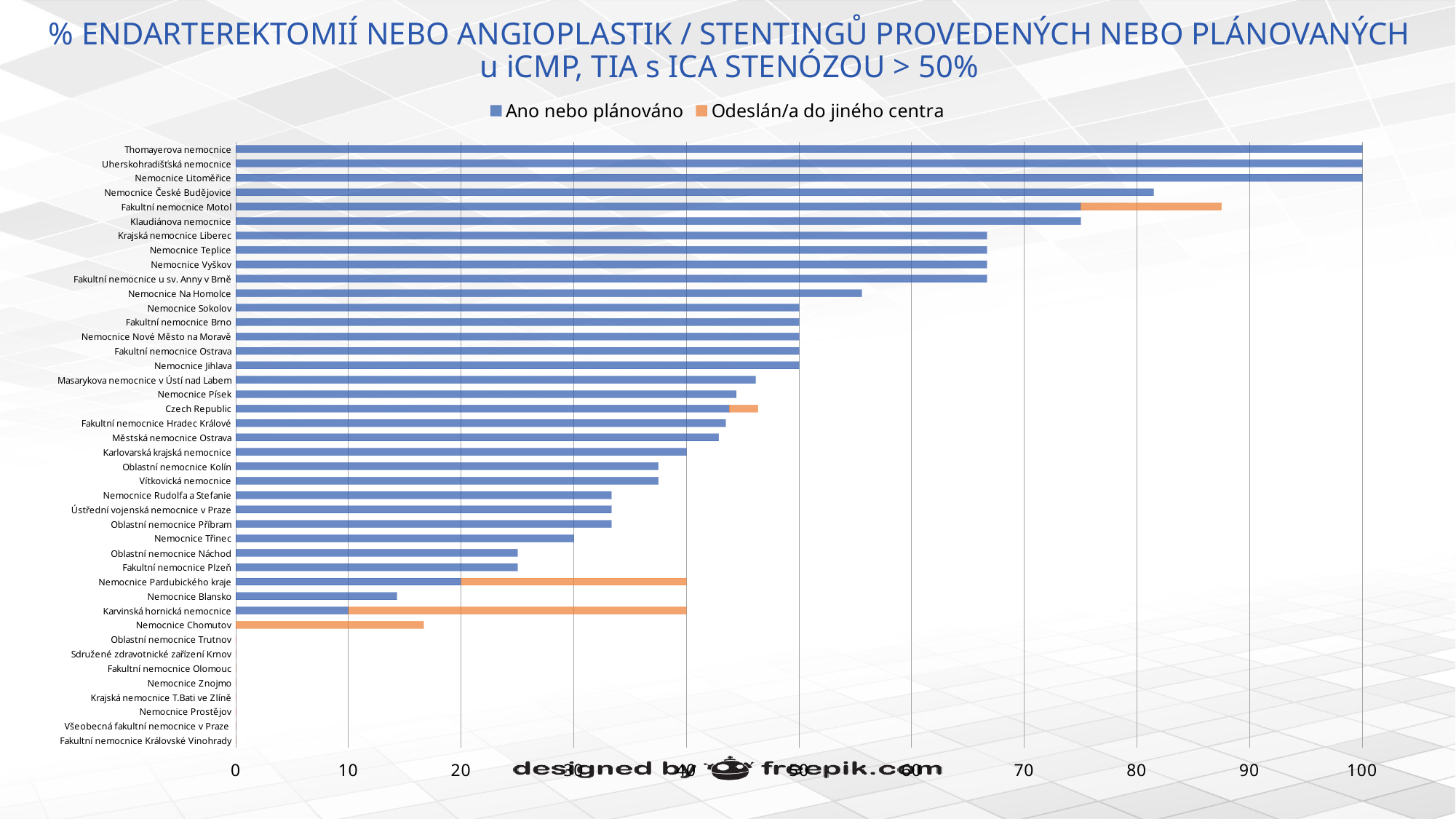
How many series does the legend list? 2 What kind of chart is shown on the slide? bar chart What are the two series named in the legend? Ano nebo plánováno; Odeslán/a do jiného centra What is the value of 'Ano nebo plánováno' for Thomayerova nemocnice? 100 Which has a larger 'Ano nebo plánováno' value, Krajská nemocnice Liberec or Oblastní nemocnice Kolín? Krajská nemocnice Liberec What is the total of the stacked bar for Nemocnice Pardubického kraje? 40 What is the value of 'Ano nebo plánováno' for Nemocnice Třinec? 30 What is the value of 'Ano nebo plánováno' for Karvinská hornická nemocnice? 10 What is the difference between the 'Ano nebo plánováno' values for Thomayerova nemocnice and Nemocnice Třinec? 70 What is the value of 'Ano nebo plánováno' for Karlovarská krajská nemocnice? 40 Is the 'Ano nebo plánováno' value for Fakultní nemocnice Motol greater or less than 70? greater How many hospitals (categories) are listed on the vertical axis? 42